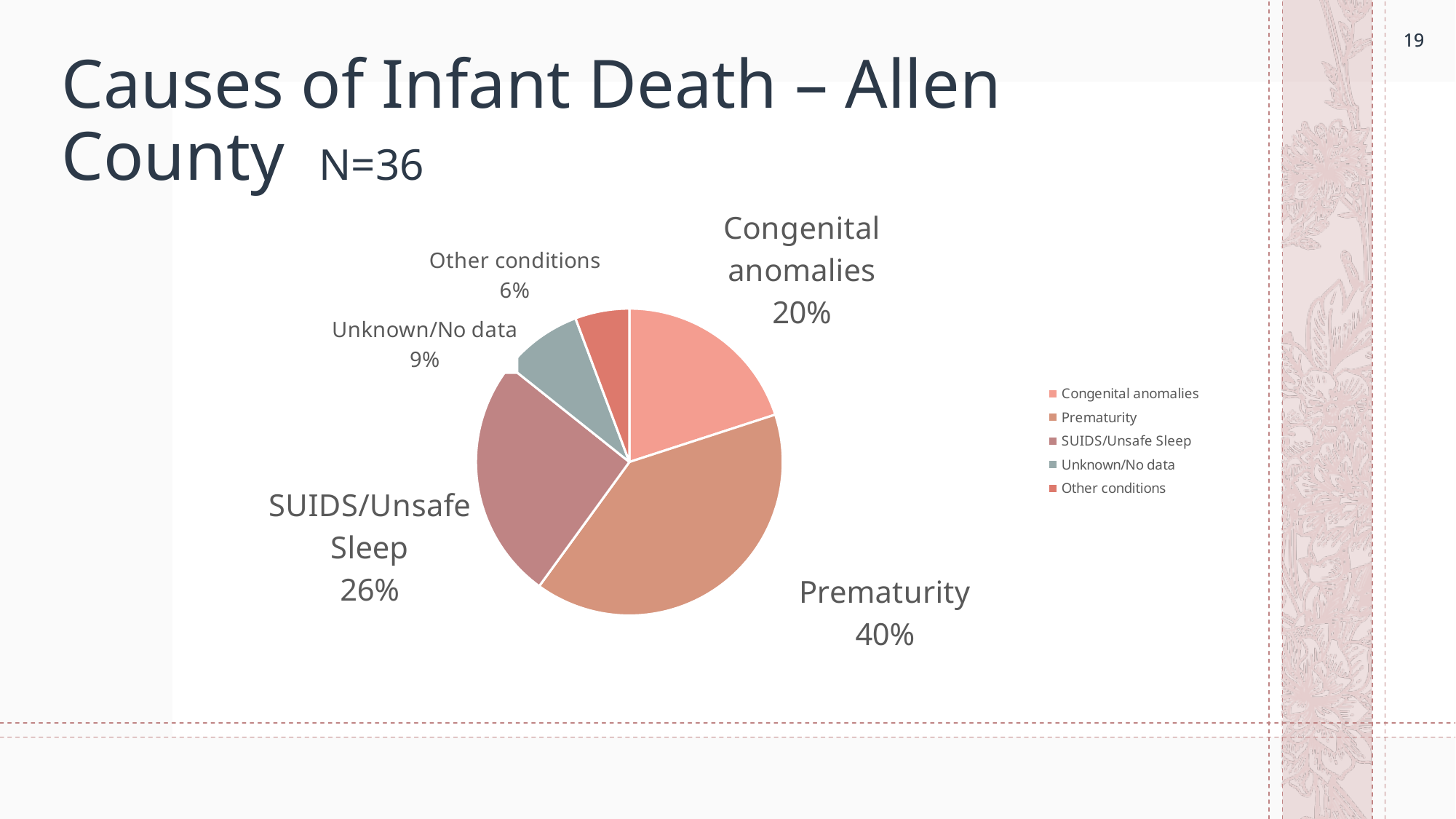
Which has a larger share, Congenital anomalies or SUIDS/Unsafe Sleep? SUIDS/Unsafe Sleep What share of infant deaths is attributed to Prematurity? 40% Which cause of infant death has the largest share? Prematurity What share of infant deaths is attributed to Unknown/No data? 9% What is the difference in percentage points between Prematurity and SUIDS/Unsafe Sleep? 14 What kind of chart is shown on the slide? Pie chart What share of infant deaths is attributed to Congenital anomalies? 20% How many categories does the pie chart show? 5 Which cause of infant death has the smallest share? Other conditions What is the total number of infant deaths (N) stated in the slide title? 36